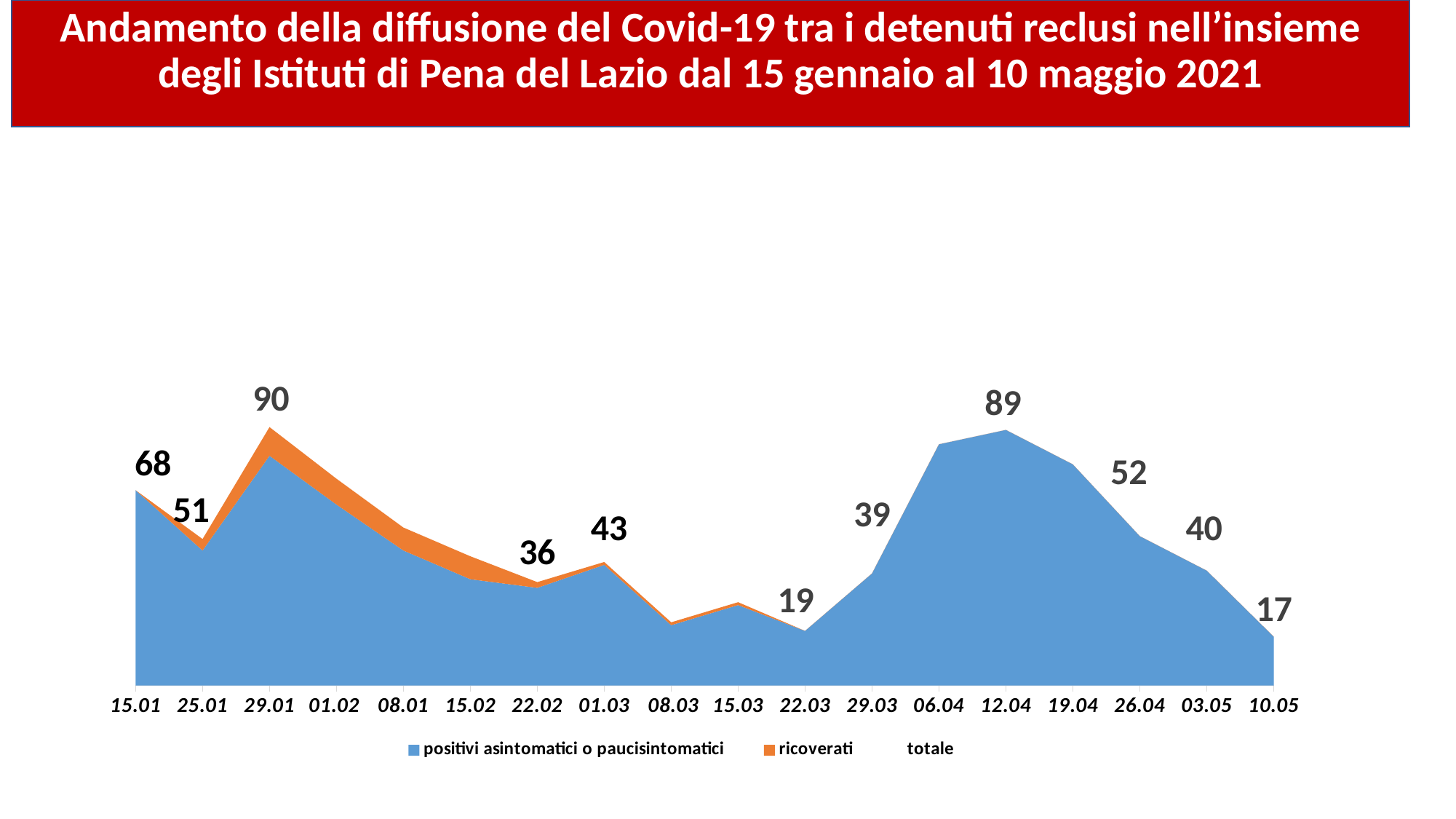
How many series does the legend list? 3 What is the total value labelled for 29.01? 90 What is the total value labelled for 12.04? 89 What is the total value labelled for 22.03? 19 What kind of chart is shown on the slide? Area chart Which date has the lowest labelled total? 10.05 Which date has the highest labelled total? 29.01 Which series is shown in orange in the legend? ricoverati What is the total value labelled for 10.05? 17 How many dates are shown on the x axis? 18 What is the difference between the labelled totals for 15.01 and 25.01? 17 Which is larger, the labelled total for 22.02 or for 01.03? 01.03